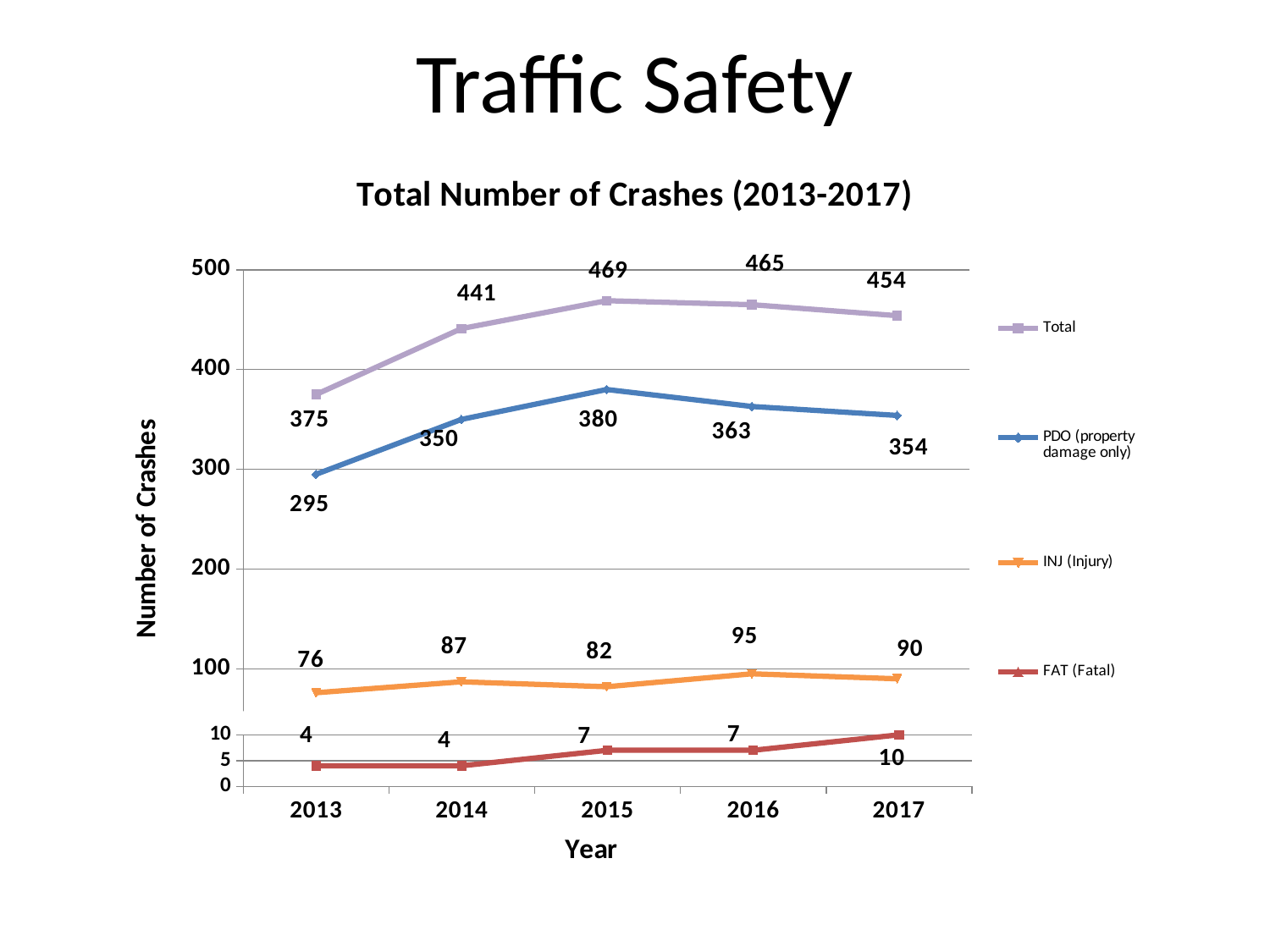
What is the difference between the Total crashes in 2014 and 2013? 66 What is the Total number of crashes in 2015? 469 What is the title of the chart? Total Number of Crashes (2013-2017) In which year is the PDO (property damage only) value lowest? 2013 What kind of chart is shown? Line chart How many series does the legend list? 4 Which is larger, the INJ (Injury) value in 2014 or in 2015? 2014 What is the PDO (property damage only) value for 2013? 295 What is the INJ (Injury) value for 2016? 95 What is the FAT (Fatal) value for 2017? 10 In which year is the Total number of crashes highest? 2015 How many years are shown on the x axis? 5